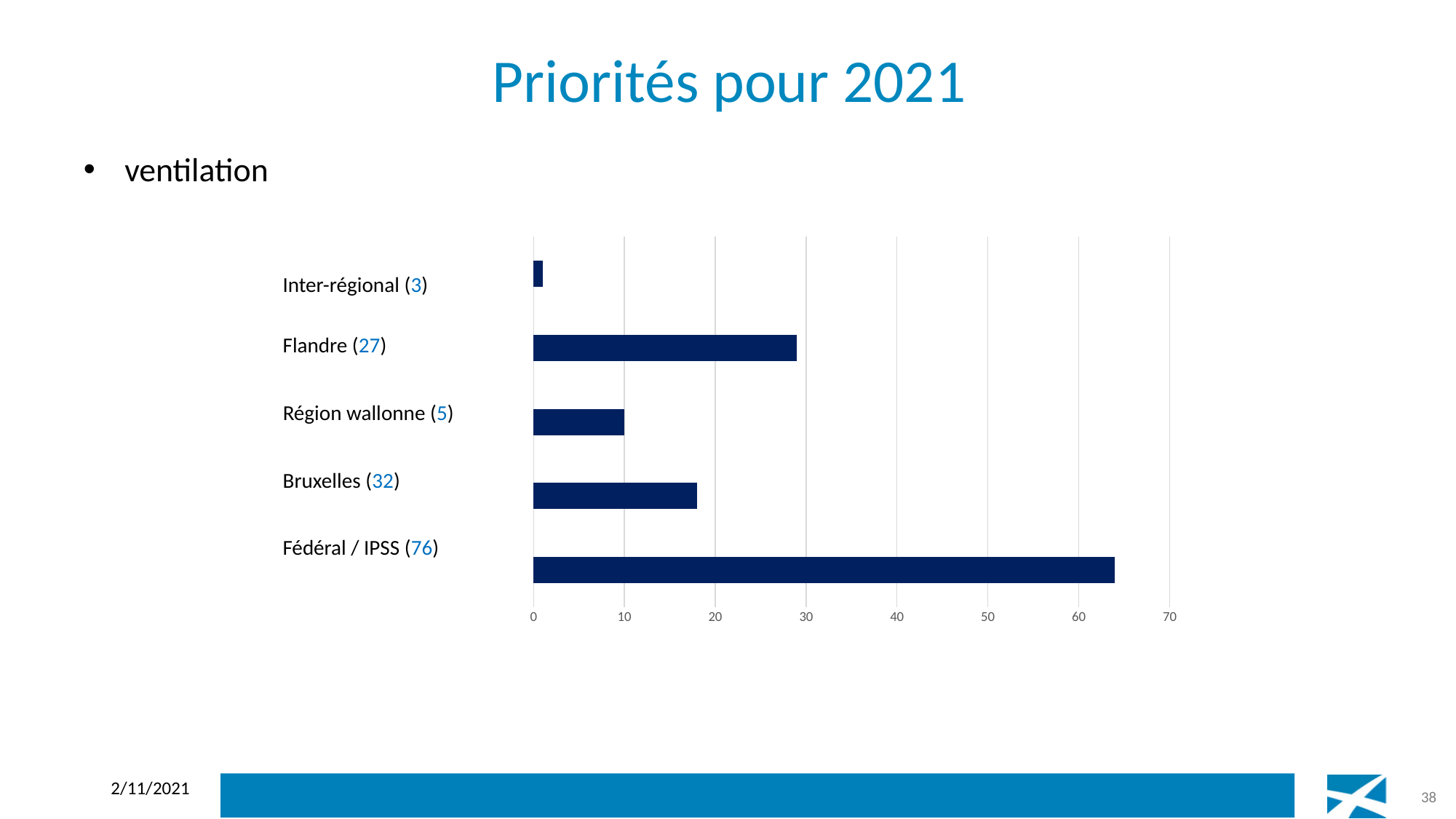
Is the bar for Fédéral / IPSS (76) greater or less than 60? greater Is the bar for Flandre (27) greater or less than 20? greater Which category has the longest bar in the chart? Fédéral / IPSS (76) What number appears in parentheses in the category label for Bruxelles? 32 Which has the longer bar, Bruxelles (32) or Région wallonne (5)? Bruxelles (32) What is the highest value shown on the horizontal axis of the chart? 70 Which category has the shortest bar in the chart? Inter-régional (3) How many categories are plotted in the chart? 5 Is the bar for Inter-régional (3) greater or less than 10? less What kind of chart is shown on the slide? bar chart Which has the longer bar, Flandre (27) or Bruxelles (32)? Flandre (27)